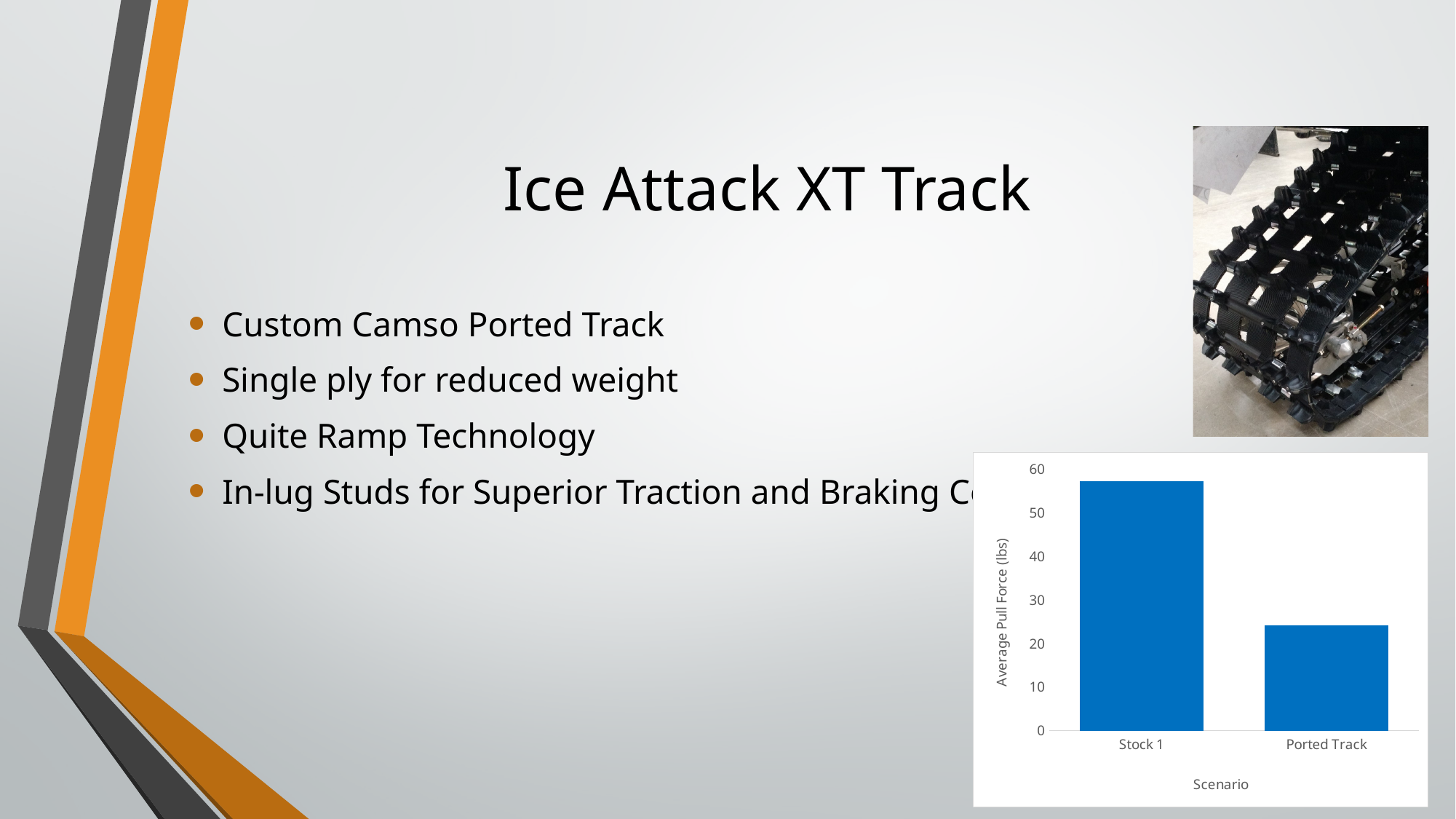
Which scenario has the lowest average pull force? Ported Track What is the label of the chart's horizontal axis? Scenario Is the value for Ported Track greater or less than 20? greater How many categories are plotted on the x axis of the chart? 2 Which has a larger average pull force, Stock 1 or Ported Track? Stock 1 Is the value for Stock 1 greater or less than 60? less What kind of chart is shown on the slide? bar chart Do the values rise or fall from Stock 1 to Ported Track? fall Is the value for Stock 1 greater or less than 50? greater What is the label of the chart's vertical axis? Average Pull Force (lbs) Which scenario has the highest average pull force? Stock 1